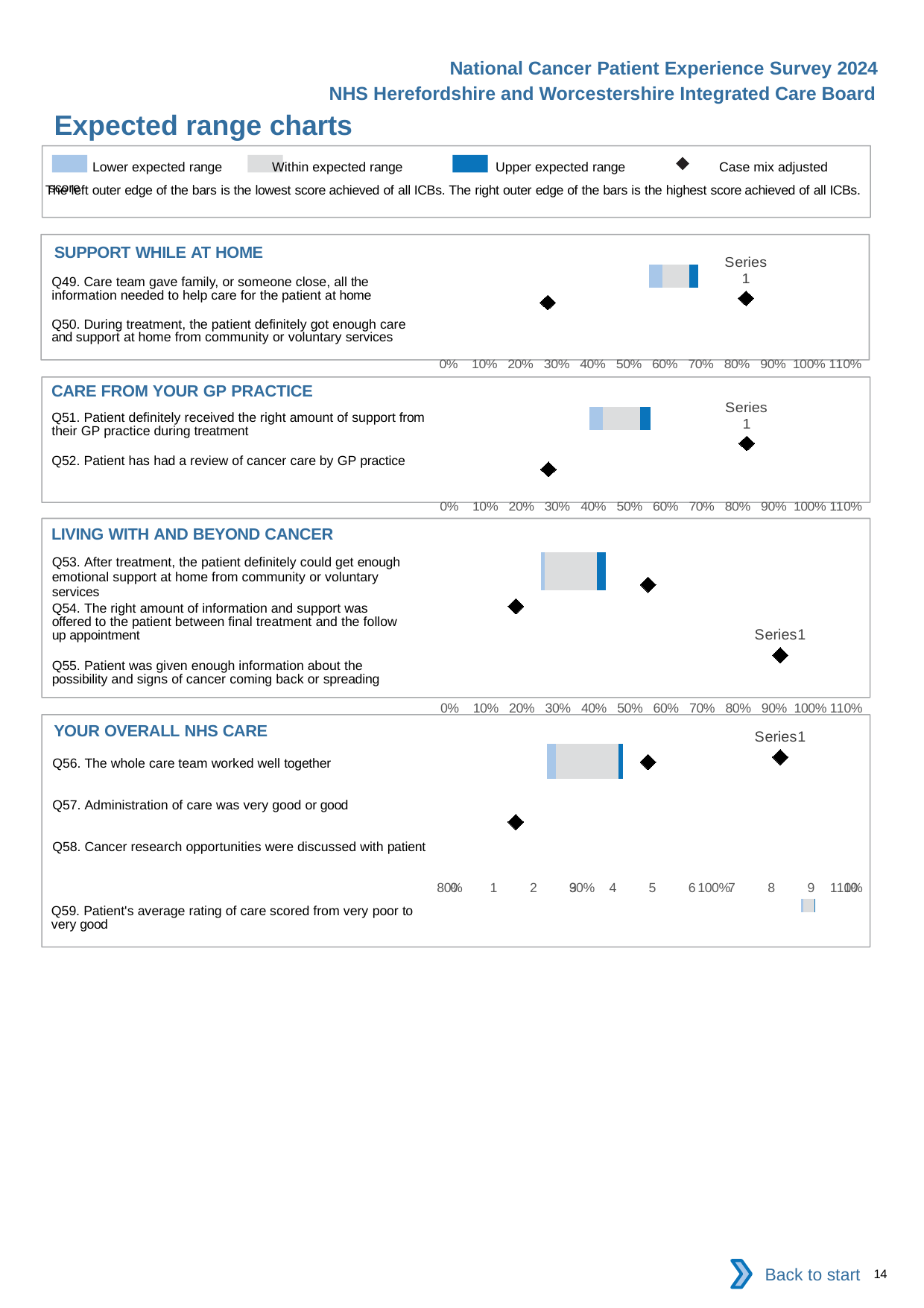
In the YOUR OVERALL NHS CARE chart, is the diamond labelled Series1 greater or less than 80%? greater How many questions are listed in the YOUR OVERALL NHS CARE chart? 4 What kind of chart is used in each section of this slide? bar chart In the CARE FROM YOUR GP PRACTICE chart, is the diamond labelled Series 1 greater or less than 70%? greater How many questions are listed in the CARE FROM YOUR GP PRACTICE chart? 2 What does the black diamond marker represent according to the legend? Case mix adjusted score What is the highest percentage tick shown on the x axis of the SUPPORT WHILE AT HOME chart? 110% How many questions are listed in the LIVING WITH AND BEYOND CANCER chart? 3 In the LIVING WITH AND BEYOND CANCER chart, is the diamond labelled Series1 greater or less than 80%? greater How many entries does the legend at the top of the slide list? 4